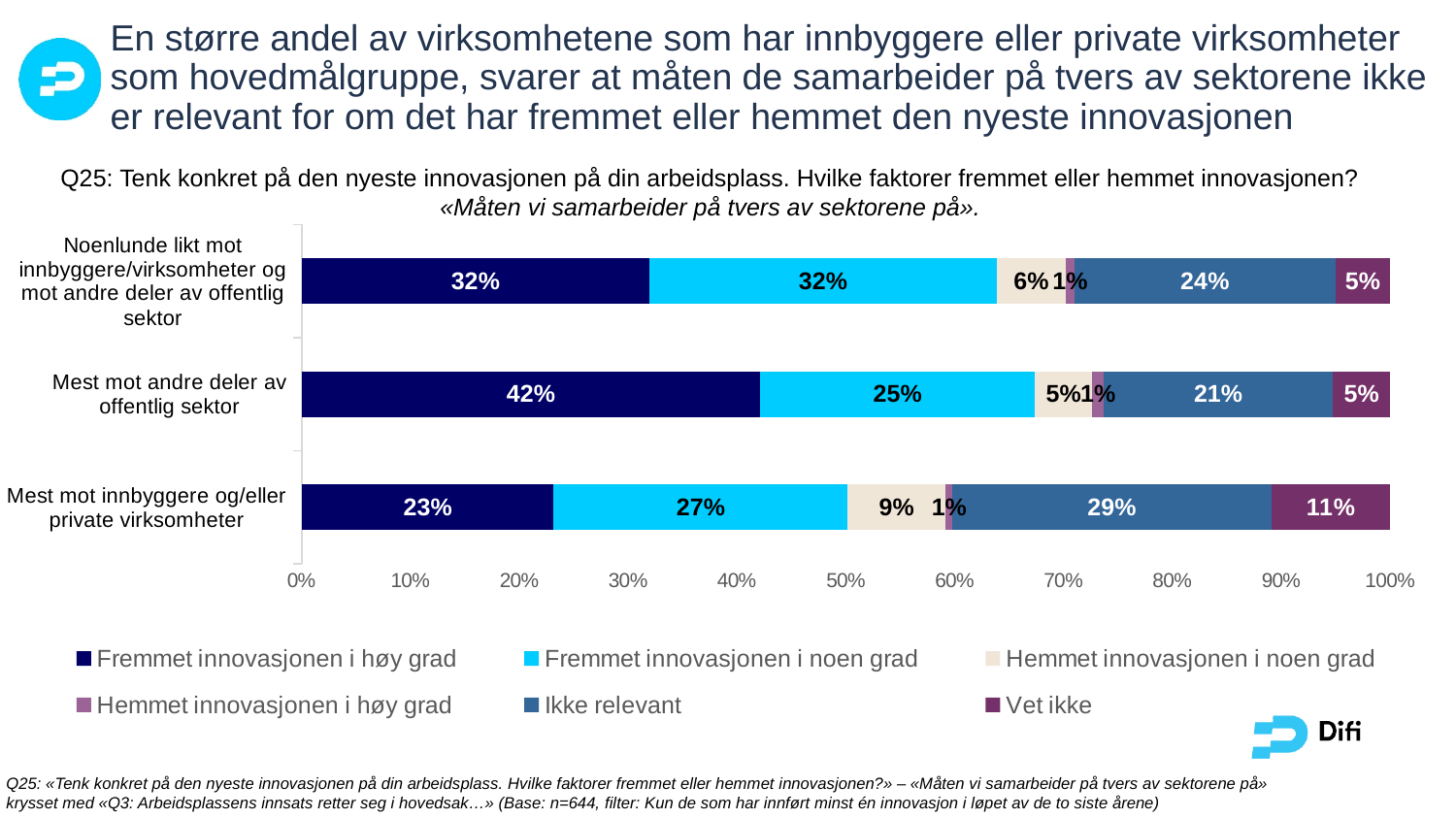
Which legend entry is shown in the lightest (beige) colour? Hemmet innovasjonen i noen grad Which is larger: 'Hemmet innovasjonen i noen grad' for 'Mest mot innbyggere og/eller private virksomheter' or for 'Mest mot andre deler av offentlig sektor'? Mest mot innbyggere og/eller private virksomheter How many categories are shown on the vertical axis? 3 What kind of chart is shown on the slide? Stacked bar chart What is the value of 'Ikke relevant' for 'Mest mot innbyggere og/eller private virksomheter'? 29% What is the value of 'Vet ikke' for 'Mest mot innbyggere og/eller private virksomheter'? 11% How many series does the legend list? 6 What is the value of 'Fremmet innovasjonen i høy grad' for 'Mest mot andre deler av offentlig sektor'? 42% Which category has the lowest value for 'Ikke relevant'? Mest mot andre deler av offentlig sektor What is the value of 'Fremmet innovasjonen i noen grad' for 'Noenlunde likt mot innbyggere/virksomheter og mot andre deler av offentlig sektor'? 32% Which category has the highest value for 'Fremmet innovasjonen i høy grad'? Mest mot andre deler av offentlig sektor What is the difference between the 'Fremmet innovasjonen i høy grad' values for 'Mest mot andre deler av offentlig sektor' and 'Mest mot innbyggere og/eller private virksomheter'? 19%